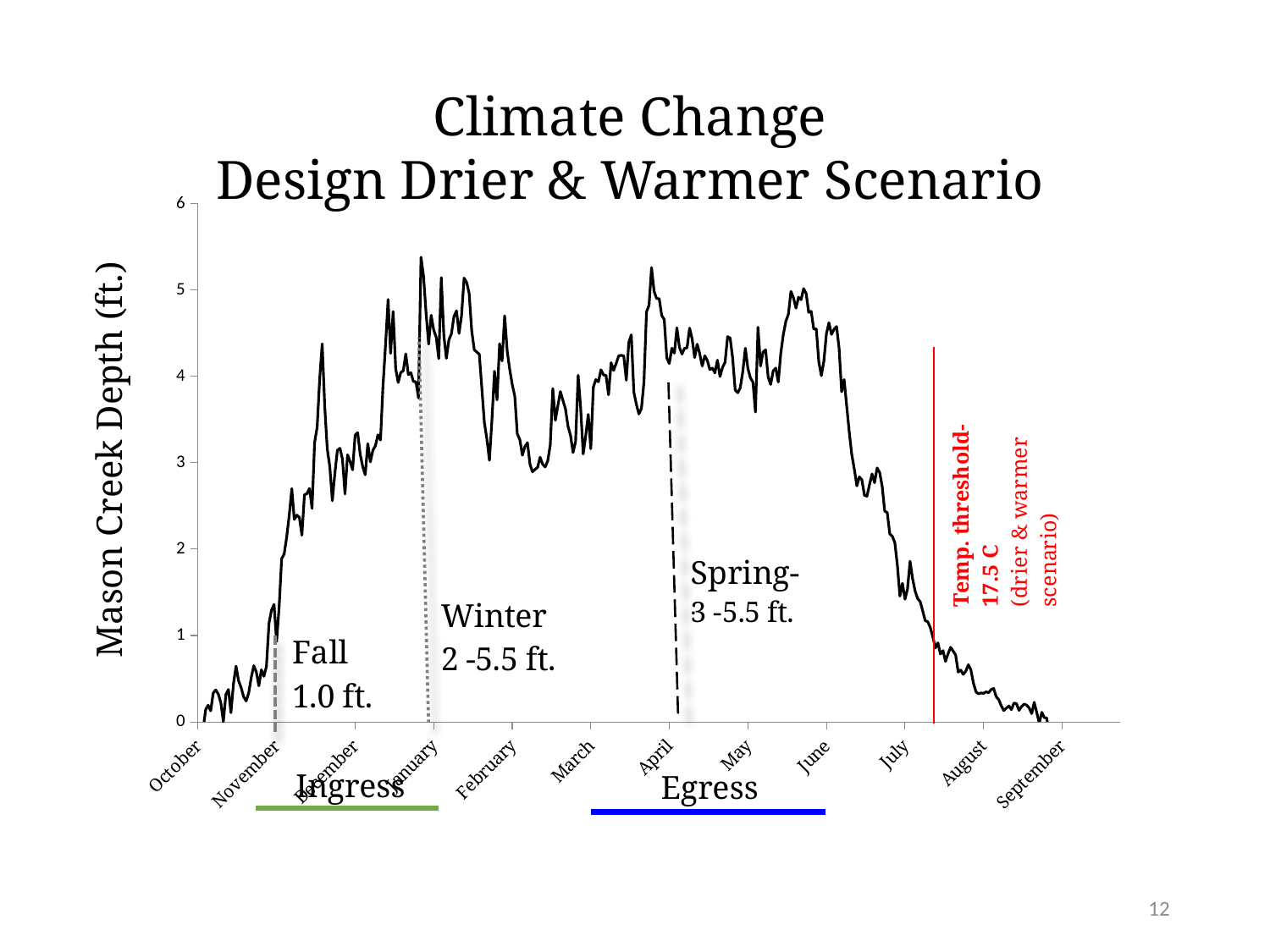
How many month labels are shown along the x axis? 12 Does the creek depth rise or fall from June to September? falls Is the creek depth at the January tick greater or less than 3? greater Is the creek depth higher at the January tick or at the September tick? January Is the creek depth at the August tick greater or less than 2? less Is the creek depth at the start of October greater or less than 1? less What is the label on the y axis? Mason Creek Depth (ft.) What temperature threshold is marked by the red vertical line? 17.5 C Does the creek depth rise or fall from October to November? rises What kind of chart is shown on the slide? line chart